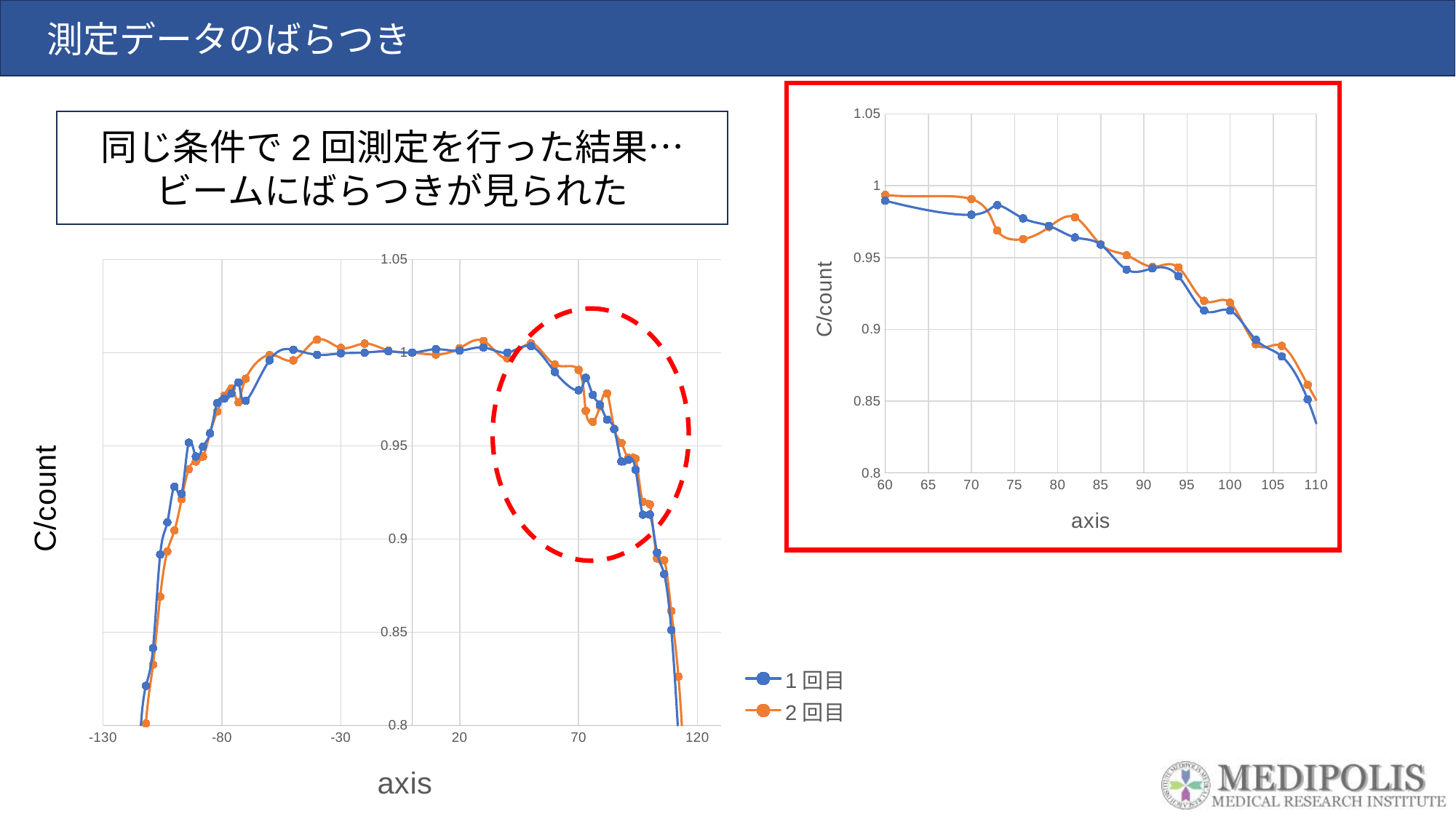
What is the label of the vertical axis on the left chart? C/count In the right (zoomed) chart, is the value for 1回目 at axis 95 greater or less than 0.95? less In the right (zoomed) chart, which series has the higher value at axis 110, 1回目 or 2回目? 2回目 In the right (zoomed) chart, is the value for 2回目 at axis 60 greater or less than 0.95? greater In the left chart, do the values rise or fall as the axis increases from 70 to 120? fall In the right (zoomed) chart, which series has the higher value at axis 73, 1回目 or 2回目? 1回目 How many series does the legend of the left chart list? 2 In the left chart, is the value for 1回目 at axis 20 greater or less than 0.95? greater What are the two series names shown in the legend of the left chart? 1回目 and 2回目 What kind of chart is the large chart on the left of the slide? line chart In the right (zoomed) chart, do the values generally rise or fall as the axis increases from 60 to 110? fall